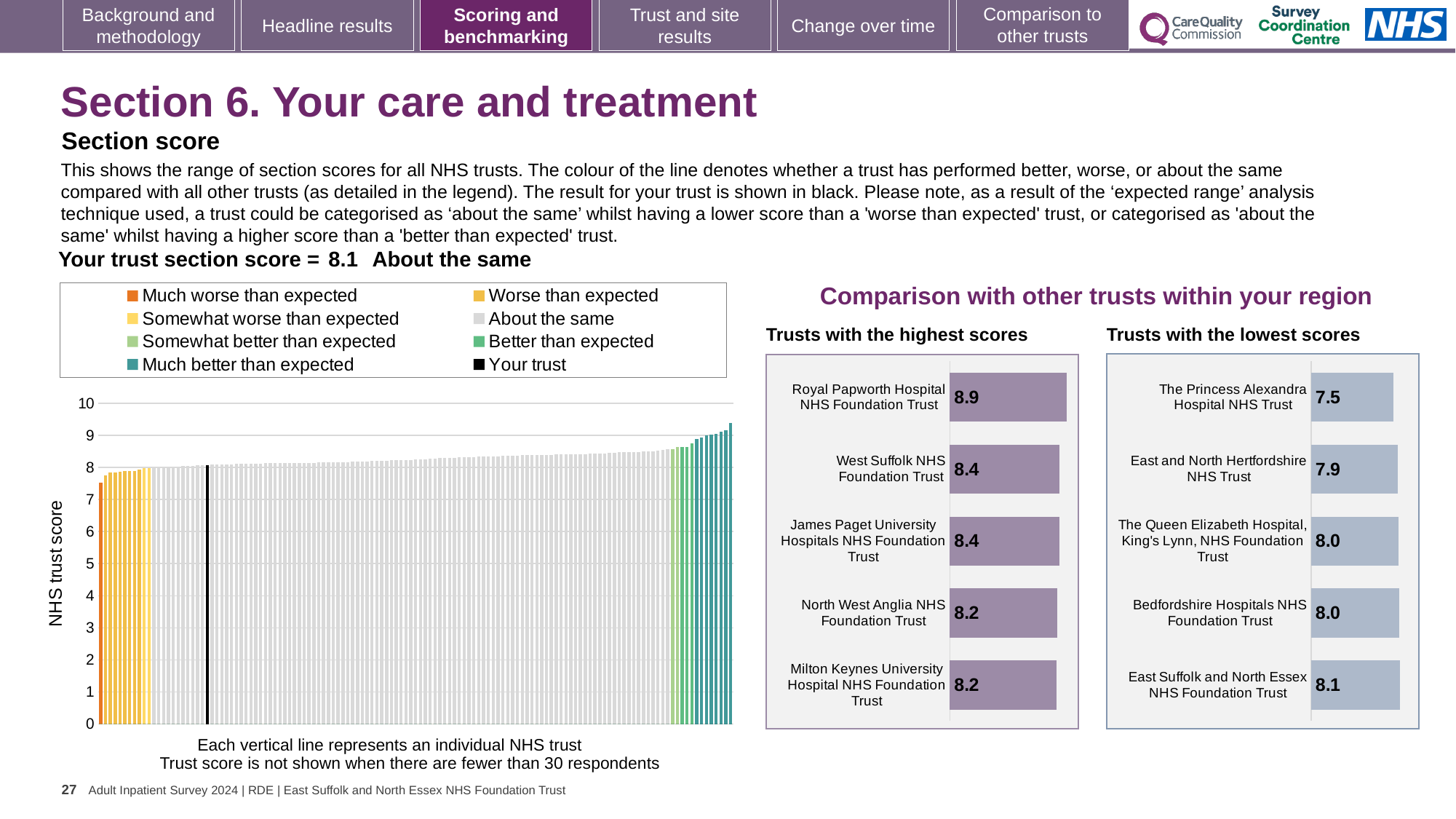
In the main 'NHS trust score' chart on the left, do the trust scores rise or fall from left to right along the x axis? rise In the 'Trusts with the highest scores' chart, what is the score for Royal Papworth Hospital NHS Foundation Trust? 8.9 What kind of chart is the main 'NHS trust score' chart on the left? bar chart In the 'Trusts with the highest scores' chart, which trust has the highest score? Royal Papworth Hospital NHS Foundation Trust In the 'Trusts with the lowest scores' chart, what is the difference between the scores of East Suffolk and North Essex NHS Foundation Trust and The Princess Alexandra Hospital NHS Trust? 0.6 In the 'Trusts with the highest scores' chart, what is the difference between the scores of Royal Papworth Hospital NHS Foundation Trust and Milton Keynes University Hospital NHS Foundation Trust? 0.7 How many entries does the legend of the main 'NHS trust score' chart list? 8 In the main 'NHS trust score' chart on the left, what is the section score for your trust? 8.1 In the 'Trusts with the lowest scores' chart, what is the score for The Princess Alexandra Hospital NHS Trust? 7.5 In the 'Trusts with the lowest scores' chart, which trust has the lowest score? The Princess Alexandra Hospital NHS Trust In the 'Trusts with the lowest scores' chart, which has the larger score: East and North Hertfordshire NHS Trust or Bedfordshire Hospitals NHS Foundation Trust? Bedfordshire Hospitals NHS Foundation Trust How many trusts are shown in the 'Trusts with the highest scores' chart? 5